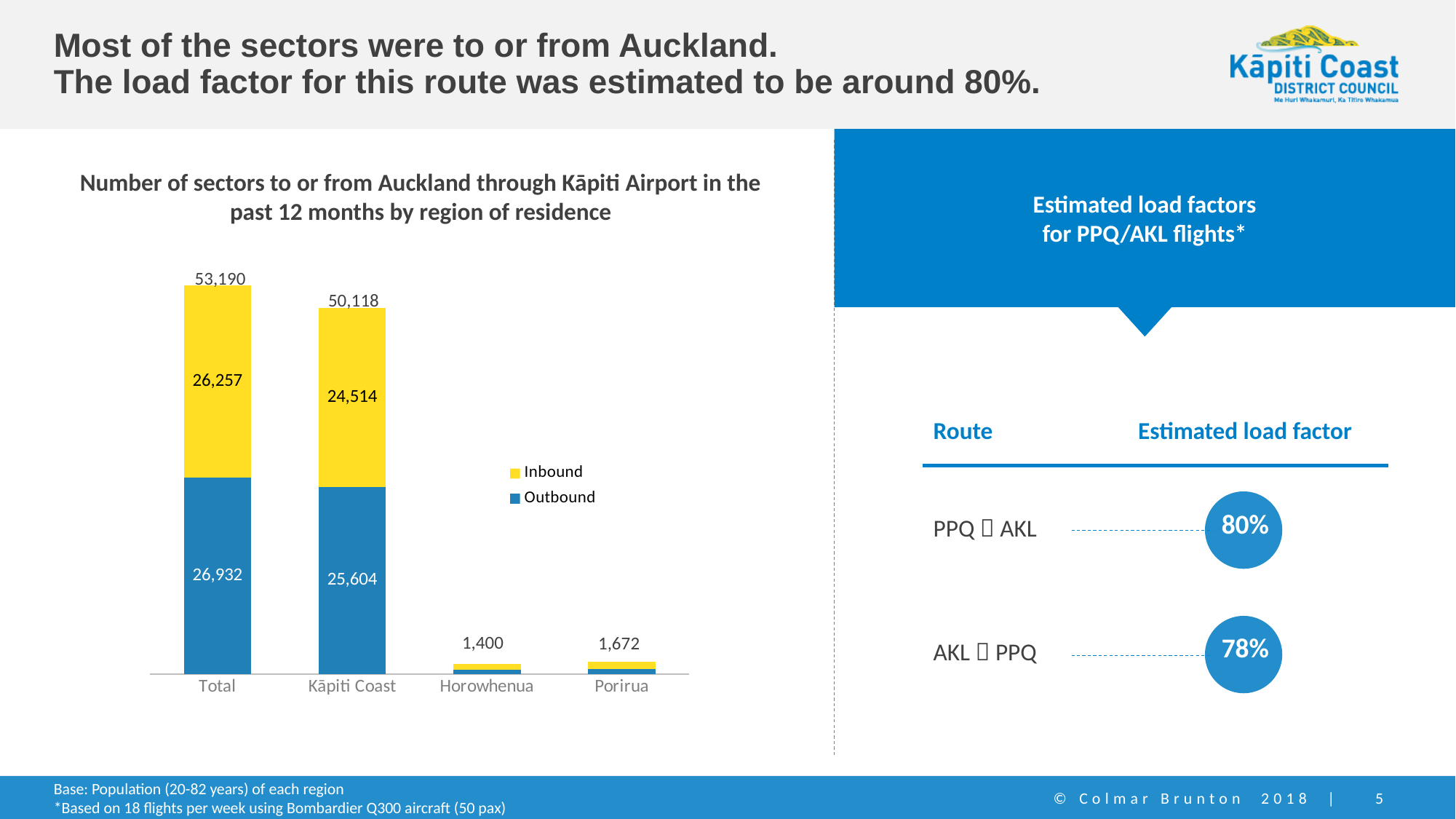
For Kāpiti Coast, which is larger: Inbound or Outbound? Outbound Which category has the highest total number of sectors? Total Which category has the lowest total number of sectors? Horowhenua What is the Inbound value for the Total category? 26,257 How many series does the chart legend list? 2 What kind of chart is used to show the number of sectors by region of residence? Stacked bar chart What is the difference between the totals for Porirua and Horowhenua? 272 What is the difference between the Outbound and Inbound values for the Total category? 675 What is the total number of sectors shown for Horowhenua? 1,400 What is the total of the stacked bar for Kāpiti Coast? 50,118 How many categories are shown on the x axis of the chart? 4 What is the Outbound value for Kāpiti Coast? 25,604